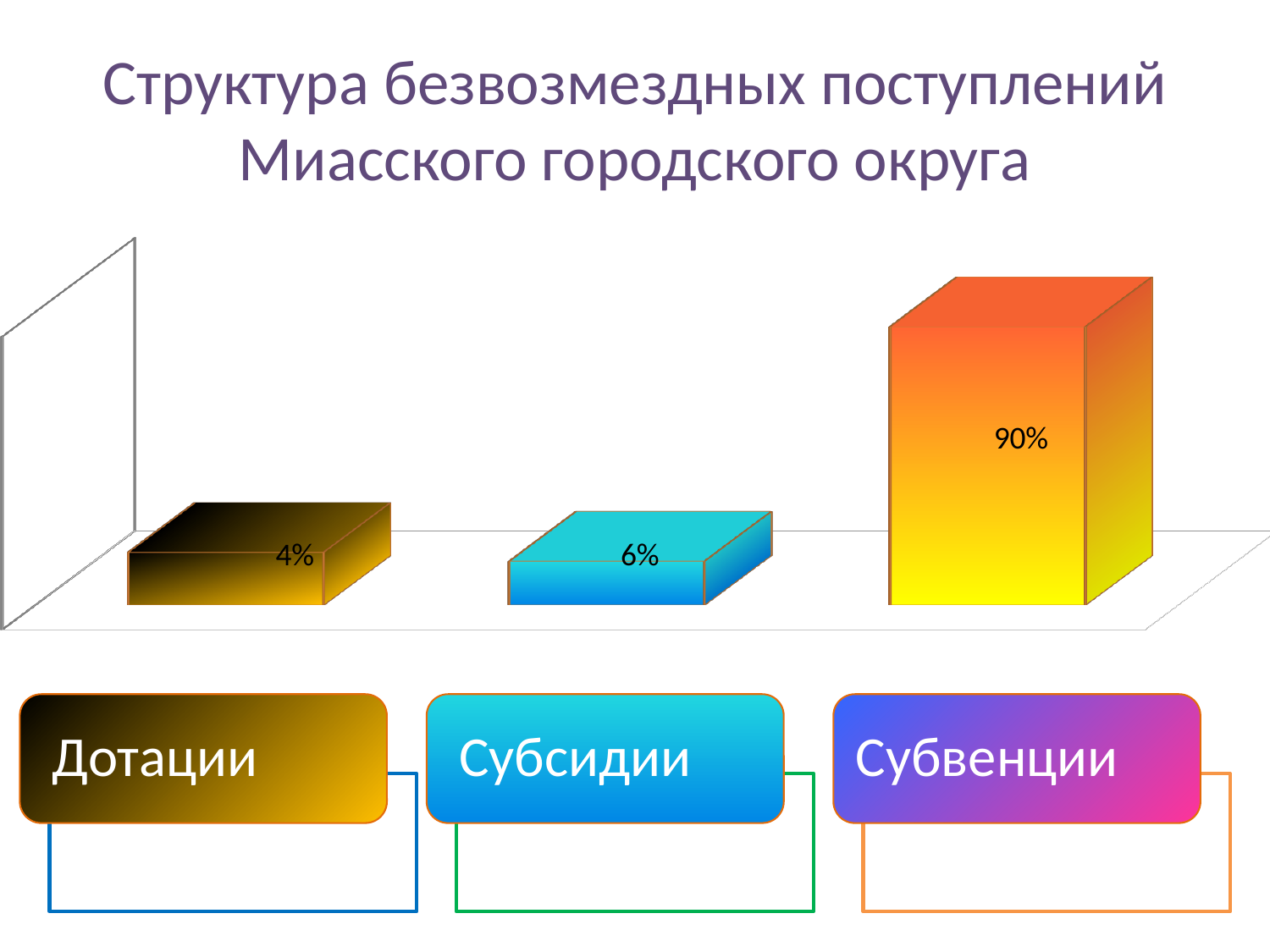
What is the value shown for Дотации? 4% Which category has the highest value? Субвенции Do the values rise or fall from left to right across the categories? rise What kind of chart is shown on the slide? bar chart How many categories are plotted in the chart? 3 What is the difference between the values for Субсидии and Дотации? 2% What is the value shown for Субсидии? 6% What is the value shown for Субвенции? 90% What is the difference between the values for Субвенции and Субсидии? 84% Which category has the lowest value? Дотации What is the title of the slide containing the chart? Структура безвозмездных поступлений Миасского городского округа Which is larger, the value for Дотации or the value for Субсидии? Субсидии